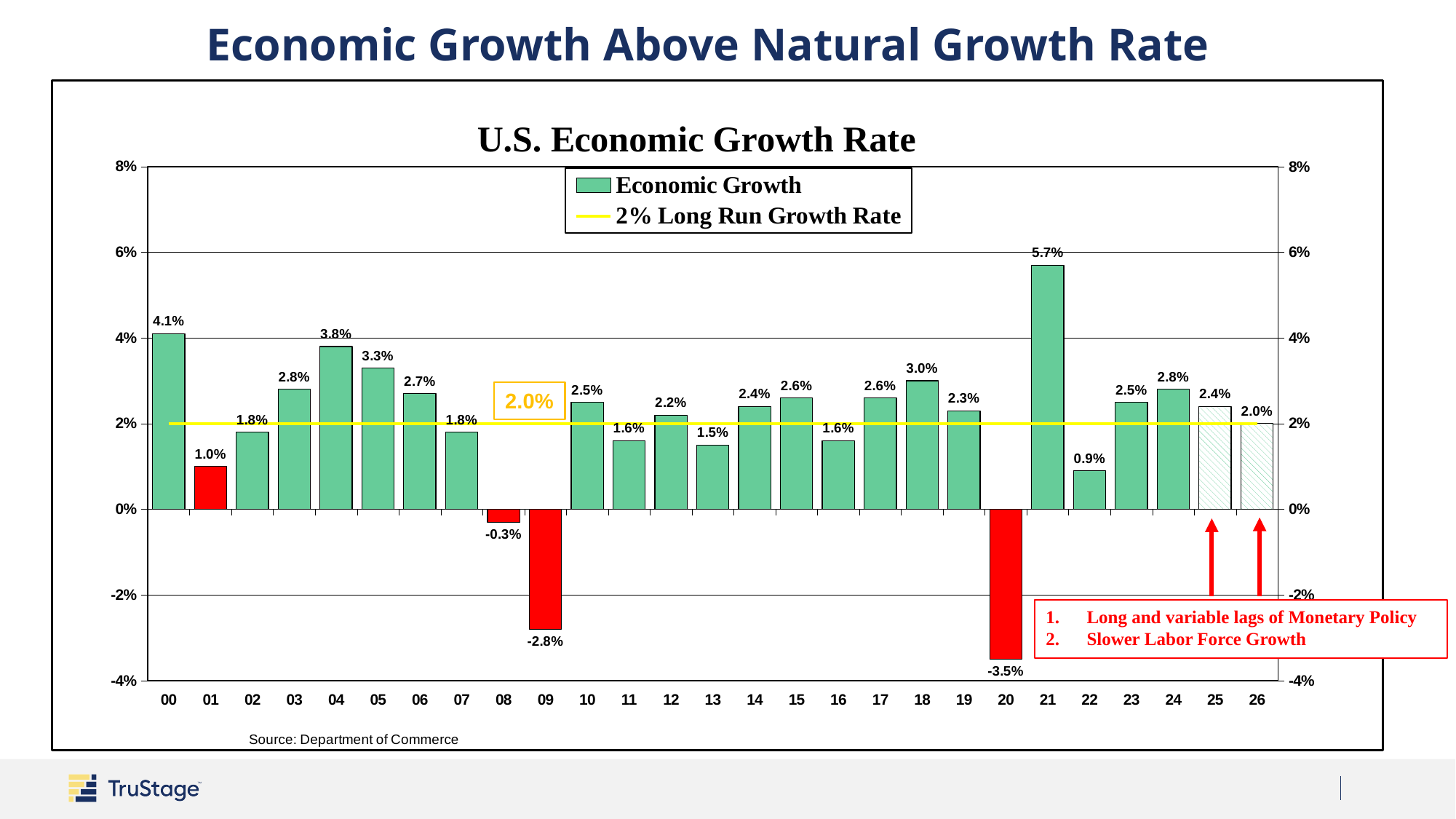
How many series does the legend list? 2 What is the economic growth rate shown for 2021? 5.7% What is the economic growth rate shown for 2009? -2.8% What is the economic growth rate shown for 2026? 2.0% What is the title of the chart? U.S. Economic Growth Rate What is the difference between the economic growth rate in 2021 and in 2022? 4.8% What value does the yellow horizontal line represent? 2% Long Run Growth Rate Which year has the highest economic growth rate? 21 Which year has a higher economic growth rate, 2004 or 2005? 04 Which year has the lowest economic growth rate? 20 What kind of chart is this? Combination bar and line chart How many years are shown on the x axis? 27